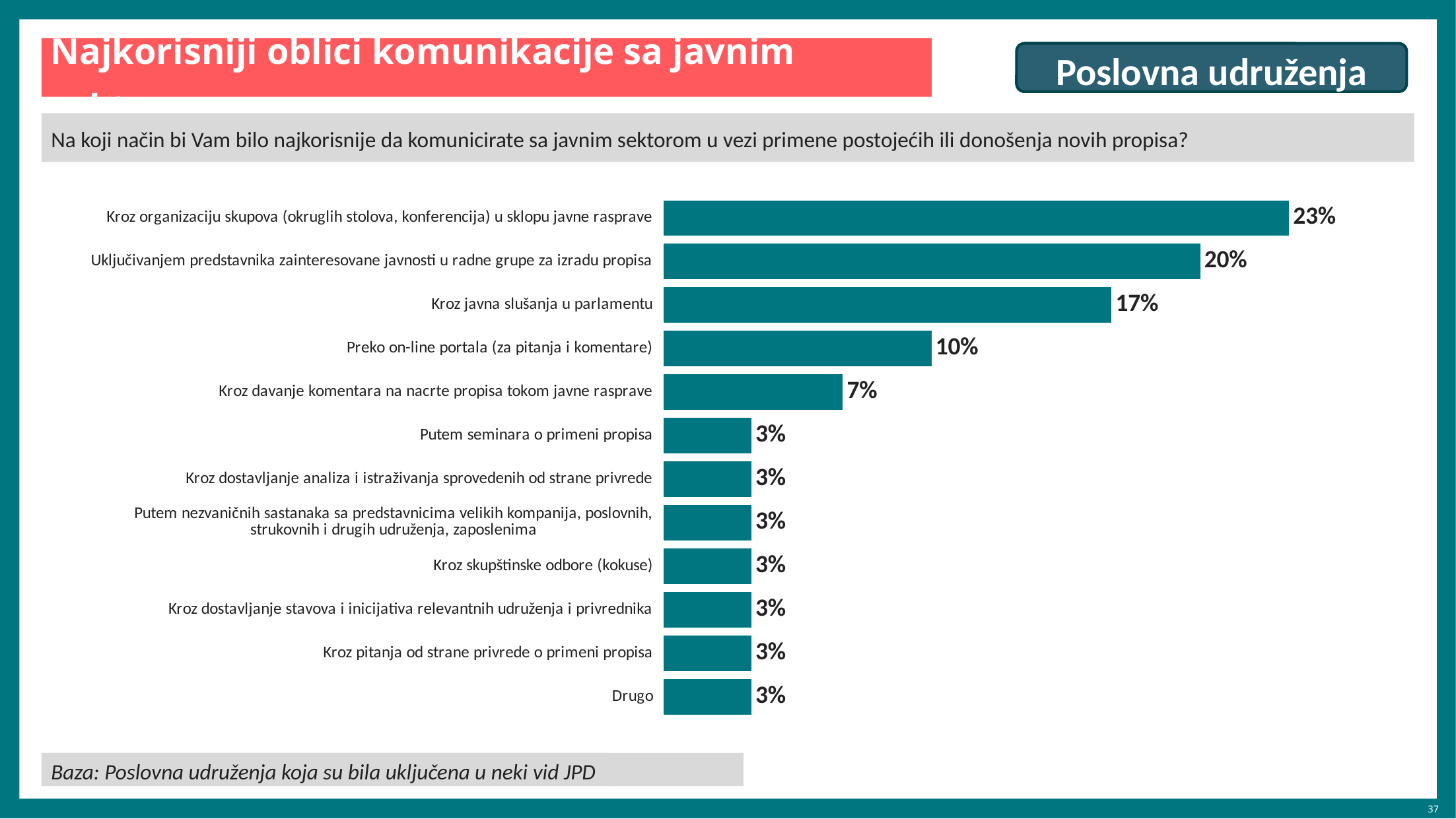
Which is larger: the value for "Uključivanjem predstavnika zainteresovane javnosti u radne grupe za izradu propisa" or the value for "Kroz javna slušanja u parlamentu"? Uključivanjem predstavnika zainteresovane javnosti u radne grupe za izradu propisa What is the value for "Drugo"? 3% What is the value for "Kroz organizaciju skupova (okruglih stolova, konferencija) u sklopu javne rasprave"? 23% How many categories have a value of 3%? 7 Which category has the highest value? Kroz organizaciju skupova (okruglih stolova, konferencija) u sklopu javne rasprave What kind of chart is shown on the slide? Bar chart What is the value for "Kroz davanje komentara na nacrte propisa tokom javne rasprave"? 7% What is the value for "Kroz javna slušanja u parlamentu"? 17% How many categories are shown in the chart? 12 What is the difference between the values for "Kroz javna slušanja u parlamentu" and "Preko on-line portala (za pitanja i komentare)"? 7% What is the difference between the values for "Kroz organizaciju skupova (okruglih stolova, konferencija) u sklopu javne rasprave" and "Uključivanjem predstavnika zainteresovane javnosti u radne grupe za izradu propisa"? 3% What is the value for "Preko on-line portala (za pitanja i komentare)"? 10%